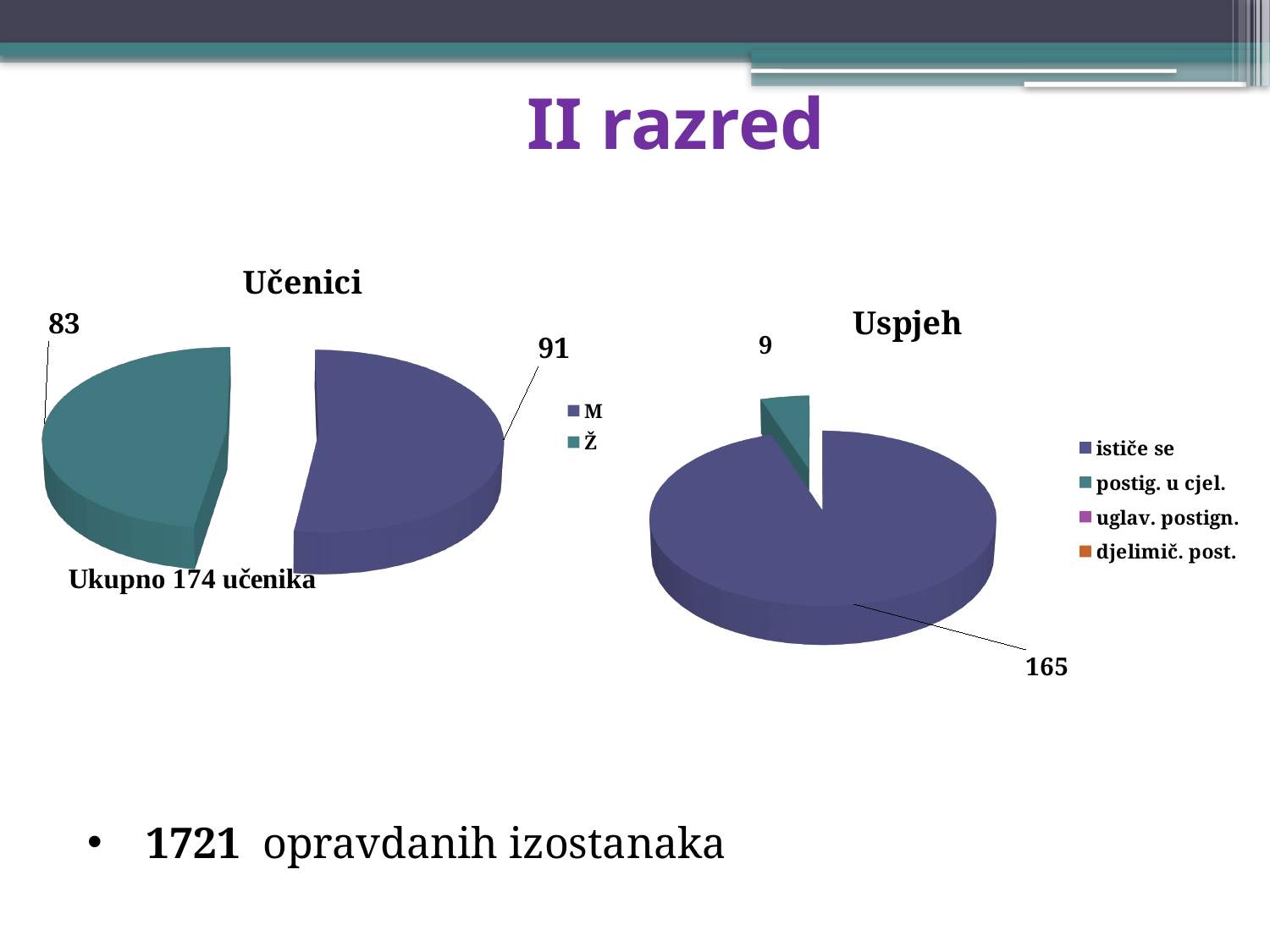
How many entries does the legend of the 'Učenici' chart list? 2 In the 'Učenici' chart, which category has the larger value, M or Ž? M In the 'Učenici' chart, what is the value for M? 91 In the 'Učenici' chart, what is the total number of students shown? 174 In the 'Učenici' chart, what is the value for Ž? 83 In the 'Uspjeh' chart, which category has the highest value? ističe se In the 'Uspjeh' chart, what is the value for 'ističe se'? 165 In the 'Uspjeh' chart, what is the difference between the values for 'ističe se' and 'postig. u cjel.'? 156 How many entries does the legend of the 'Uspjeh' chart list? 4 What kind of chart is the 'Učenici' chart? Pie chart In the 'Uspjeh' chart, what is the value for 'postig. u cjel.'? 9 In the 'Učenici' chart, what is the difference between the values for M and Ž? 8